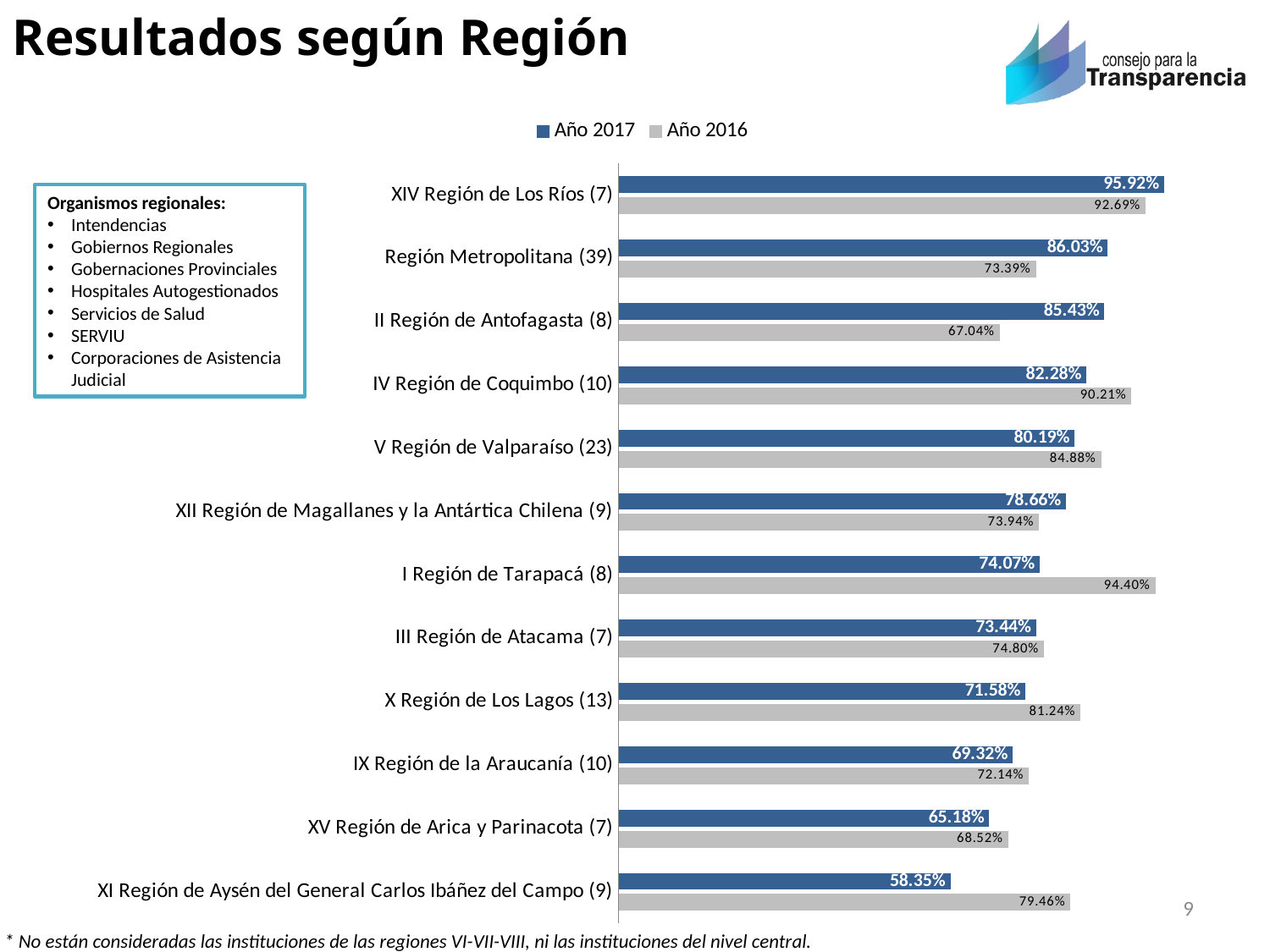
What type of chart is shown on the slide? Bar chart Which region has the lowest Año 2017 value? XI Región de Aysén del General Carlos Ibáñez del Campo (9) What is the Año 2017 value for XIV Región de Los Ríos (7)? 95.92% How many series does the legend list? 2 What is the difference between the Año 2017 and Año 2016 values for Región Metropolitana (39)? 12.64% For IV Región de Coquimbo (10), which year has the larger value, Año 2017 or Año 2016? Año 2016 Which colour represents Año 2016 in the chart? Grey What is the Año 2016 value for I Región de Tarapacá (8)? 94.40% Which region has the highest Año 2017 value? XIV Región de Los Ríos (7) Which region has the lowest Año 2016 value? II Región de Antofagasta (8) How many regions are shown in the chart? 12 What is the Año 2016 value for II Región de Antofagasta (8)? 67.04%